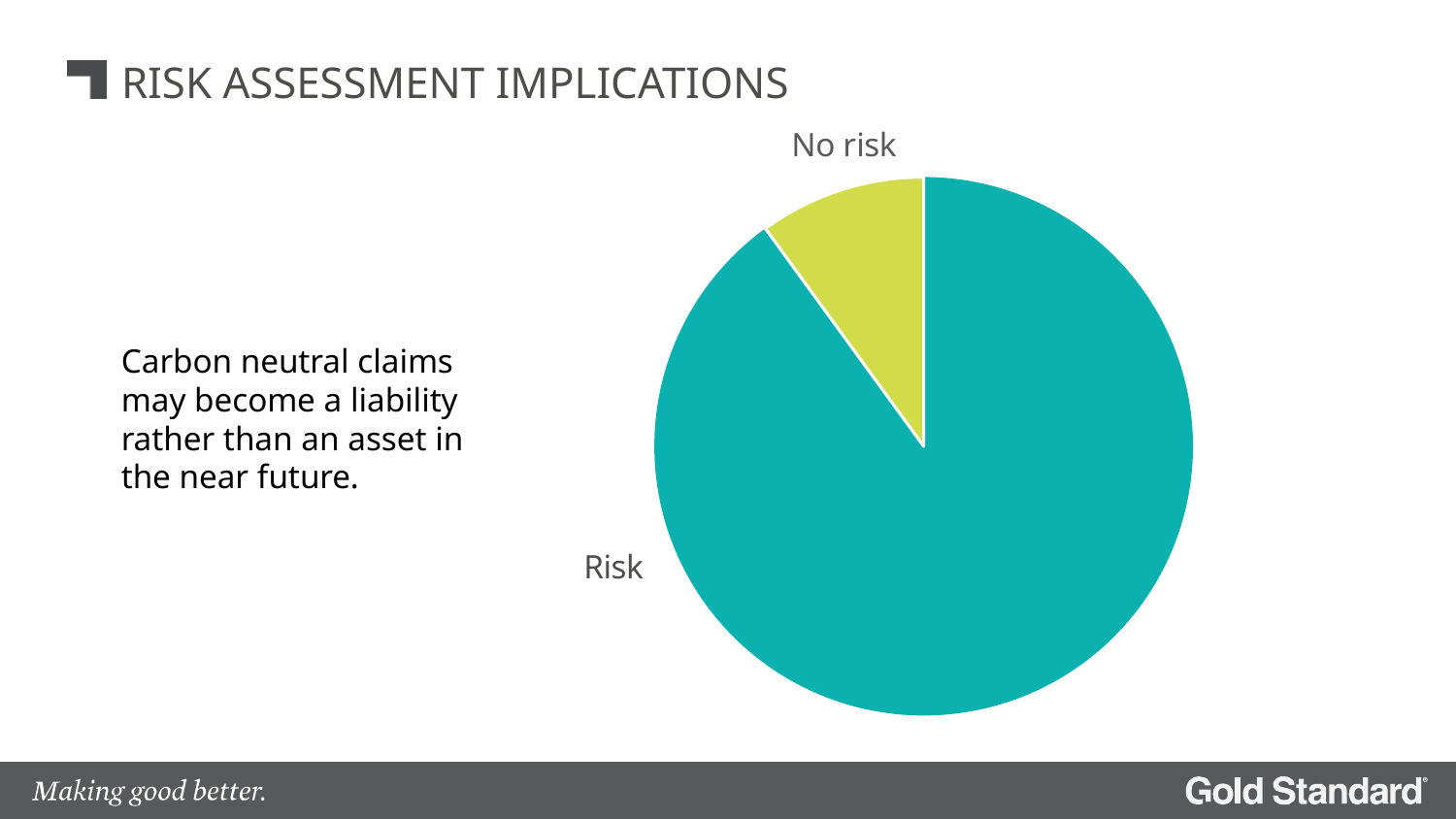
Which slice of the pie chart is the largest? Risk Which slice is larger, Risk or No risk? Risk How many slices does the pie chart have? 2 Does the Risk slice take up more or less than half of the pie? More Which slice of the pie chart is the smallest? No risk What are the labels of the two slices in the pie chart? Risk and No risk What kind of chart is shown on the slide? Pie chart What colour is the Risk slice of the pie chart? Teal